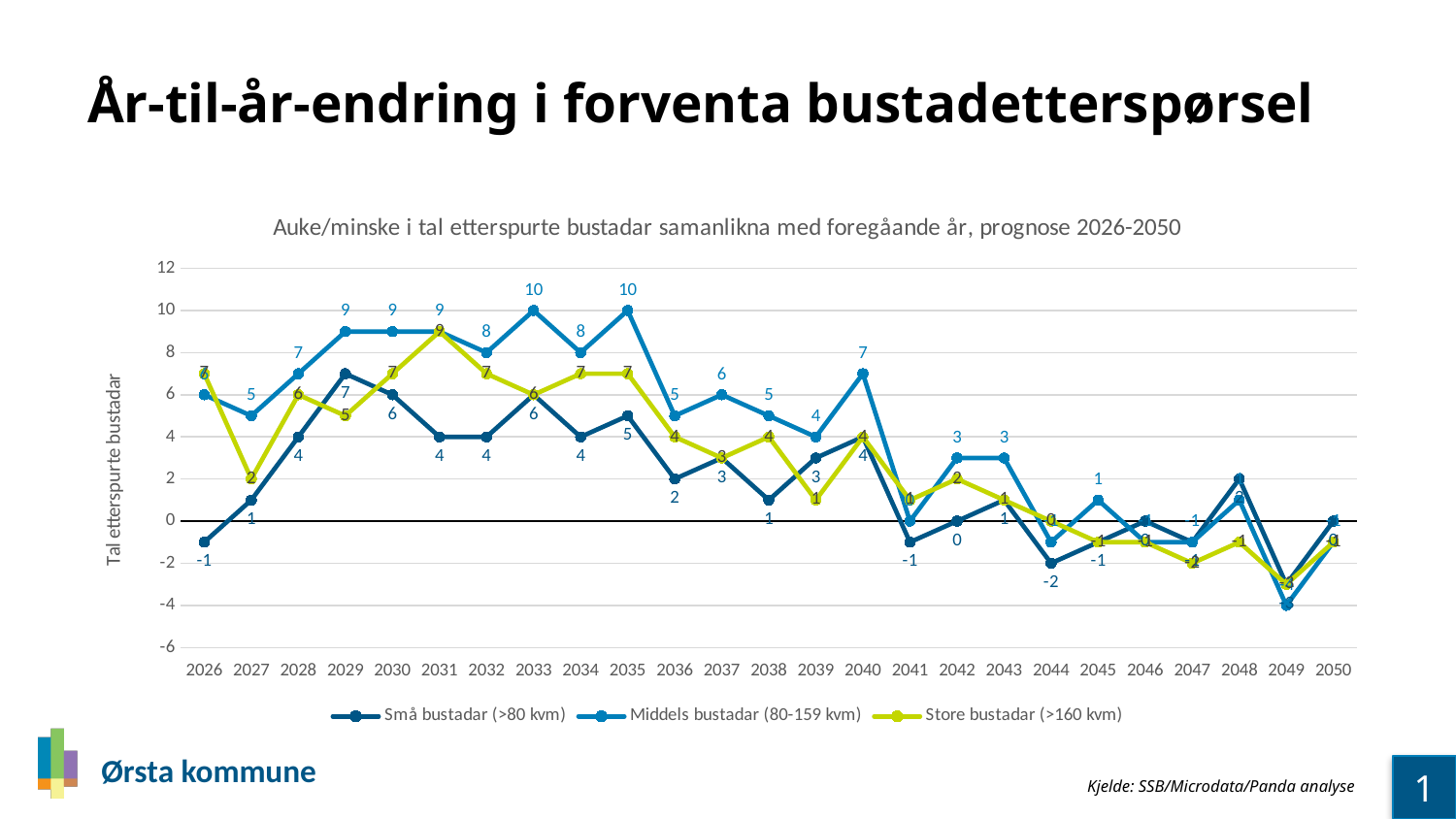
What is the value for Middels bustadar (80-159 kvm) in 2040? 7 What is the difference between Middels bustadar (80-159 kvm) and Små bustadar (>80 kvm) in 2033? 4 How many series does the legend list? 3 What is the value for Små bustadar (>80 kvm) in 2029? 7 How many years are shown on the x axis? 25 What is the value for Middels bustadar (80-159 kvm) in 2033? 10 Do the values for Middels bustadar (80-159 kvm) generally rise or fall from 2035 to 2050? fall In which year does Små bustadar (>80 kvm) reach its highest value? 2029 In 2029, which is larger: Middels bustadar (80-159 kvm) or Små bustadar (>80 kvm)? Middels bustadar (80-159 kvm) What is the value for Små bustadar (>80 kvm) in 2044? -2 Is the value for Middels bustadar (80-159 kvm) in 2049 greater or less than -2? less What kind of chart is shown on the slide? line chart